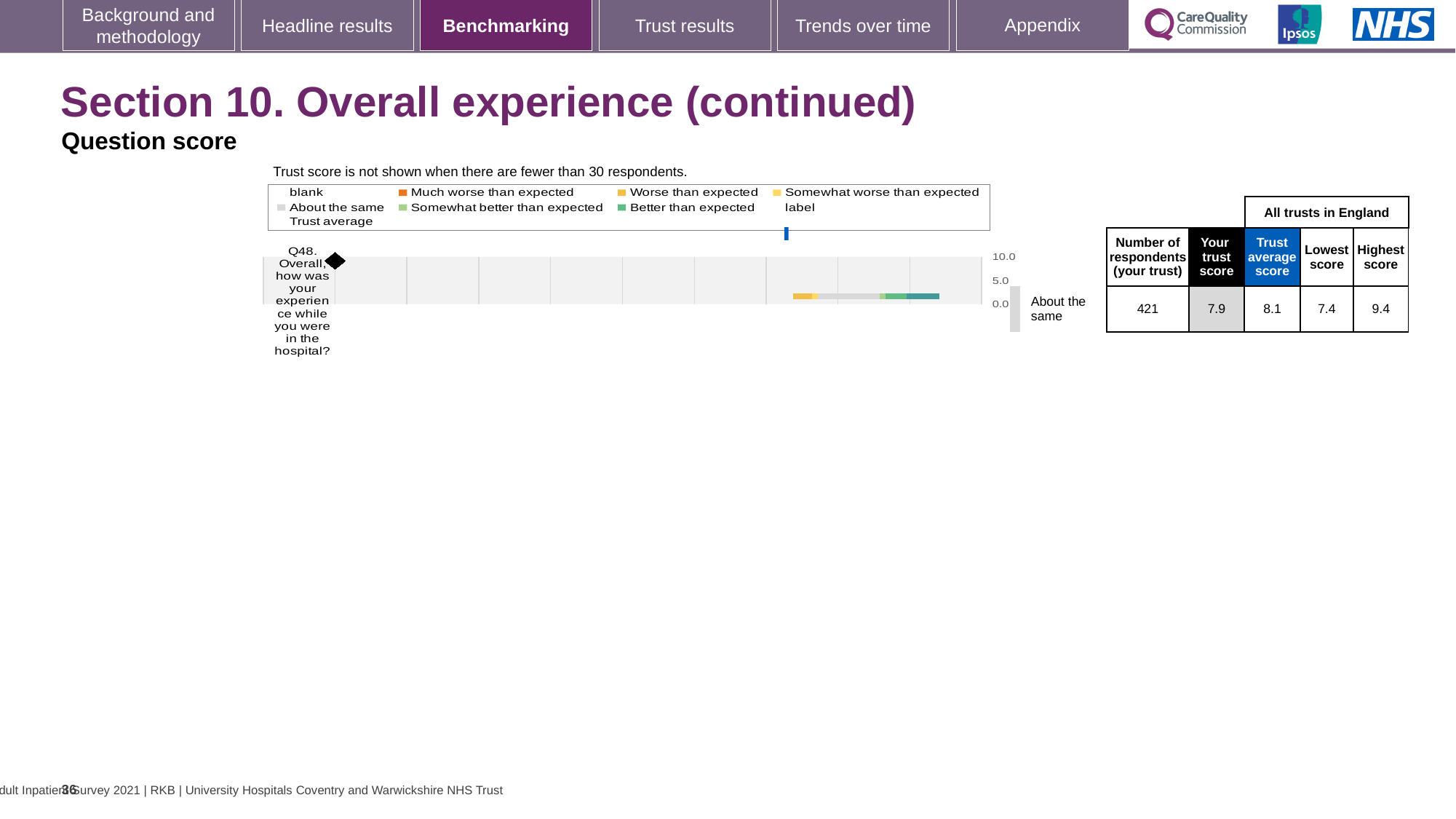
Which is larger for Q48, the trust score or the trust average score? Trust average score What is the trust average score for Q48 across all trusts in England? 8.1 How many entries does the chart legend list? 9 Which question is plotted in the chart? Q48. Overall, how was your experience while you were in the hospital? What kind of chart is shown on the slide? bar chart What is the difference between the highest score and the lowest score for Q48? 2.0 How many respondents answered Q48 for this trust? 421 What is the highest score for Q48 among all trusts in England? 9.4 What is the lowest score for Q48 among all trusts in England? 7.4 How many questions (categories) are plotted in the chart? 1 What is the trust score for Q48 shown next to the chart? 7.9 What benchmark category label is shown for Q48 next to the chart? About the same